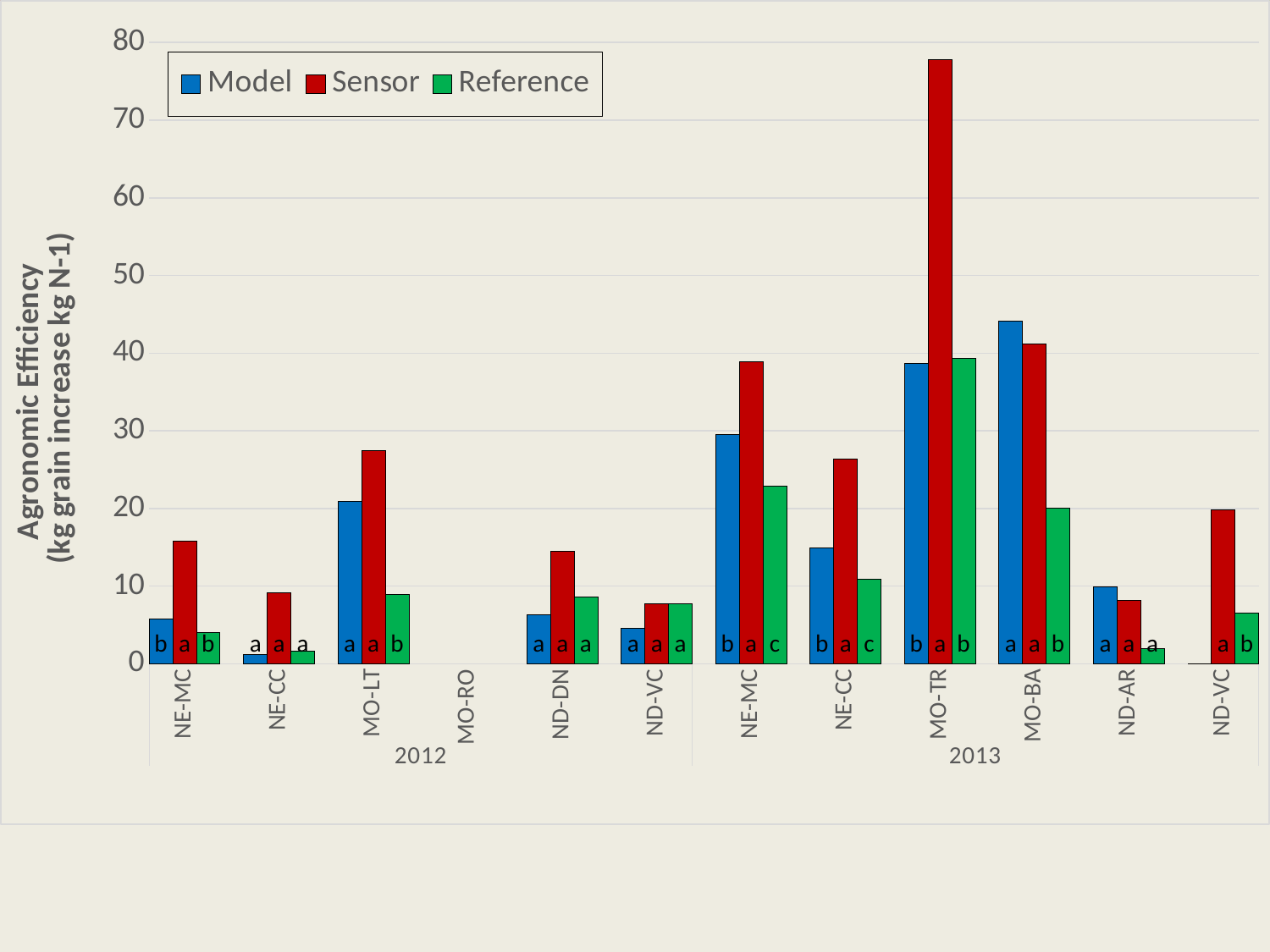
Is the Sensor value for MO-TR in 2013 greater or less than 70? greater For ND-AR in 2013, which is larger, the Model value or the Reference value? Model For MO-TR in 2013, which series has the highest value? Sensor Which site and year has the tallest bar in the chart? MO-TR (2013) Is the Model value for MO-BA in 2013 greater or less than 40? greater How many series does the legend list? 3 For NE-MC in 2013, which is larger, the Model value or the Reference value? Model Is the Model value for NE-CC in 2012 greater or less than 10? less What is the y-axis title of the chart? Agronomic Efficiency (kg grain increase kg N-1) What kind of chart is shown on the slide? bar chart Which series is shown in red in the legend? Sensor How many site categories are labelled on the x axis across both years? 12